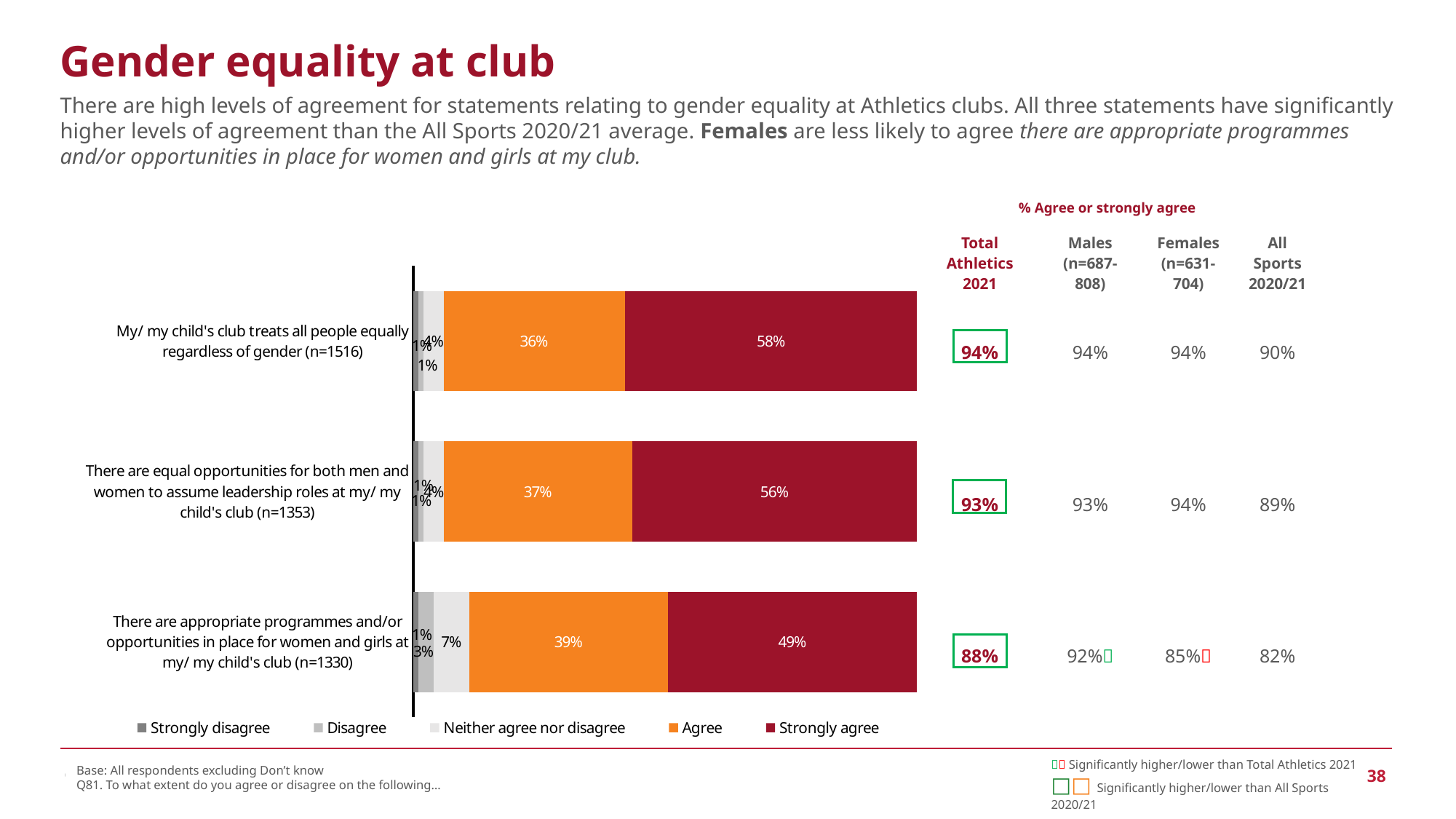
Which colour represents 'Strongly agree' in the chart? Dark red How many series does the chart legend list? 5 What is the difference between the 'Strongly agree' values for 'My/ my child's club treats all people equally regardless of gender' and 'There are appropriate programmes and/or opportunities in place for women and girls at my/ my child's club'? 9% Which is larger: the 'Agree' value for 'My/ my child's club treats all people equally regardless of gender' or the 'Agree' value for 'There are appropriate programmes and/or opportunities in place for women and girls at my/ my child's club'? There are appropriate programmes and/or opportunities in place for women and girls at my/ my child's club What is the 'Agree' value for 'There are equal opportunities for both men and women to assume leadership roles at my/ my child's club'? 37% What is the 'Strongly agree' value for 'My/ my child's club treats all people equally regardless of gender'? 58% What is the 'Strongly agree' value for 'There are appropriate programmes and/or opportunities in place for women and girls at my/ my child's club'? 49% How many statements (categories) are plotted in the chart? 3 What is the 'Neither agree nor disagree' value for 'There are appropriate programmes and/or opportunities in place for women and girls at my/ my child's club'? 7% What kind of chart is shown on the slide? Stacked bar chart Which statement has the lowest 'Strongly agree' value? There are appropriate programmes and/or opportunities in place for women and girls at my/ my child's club Which statement has the highest 'Strongly agree' value? My/ my child's club treats all people equally regardless of gender